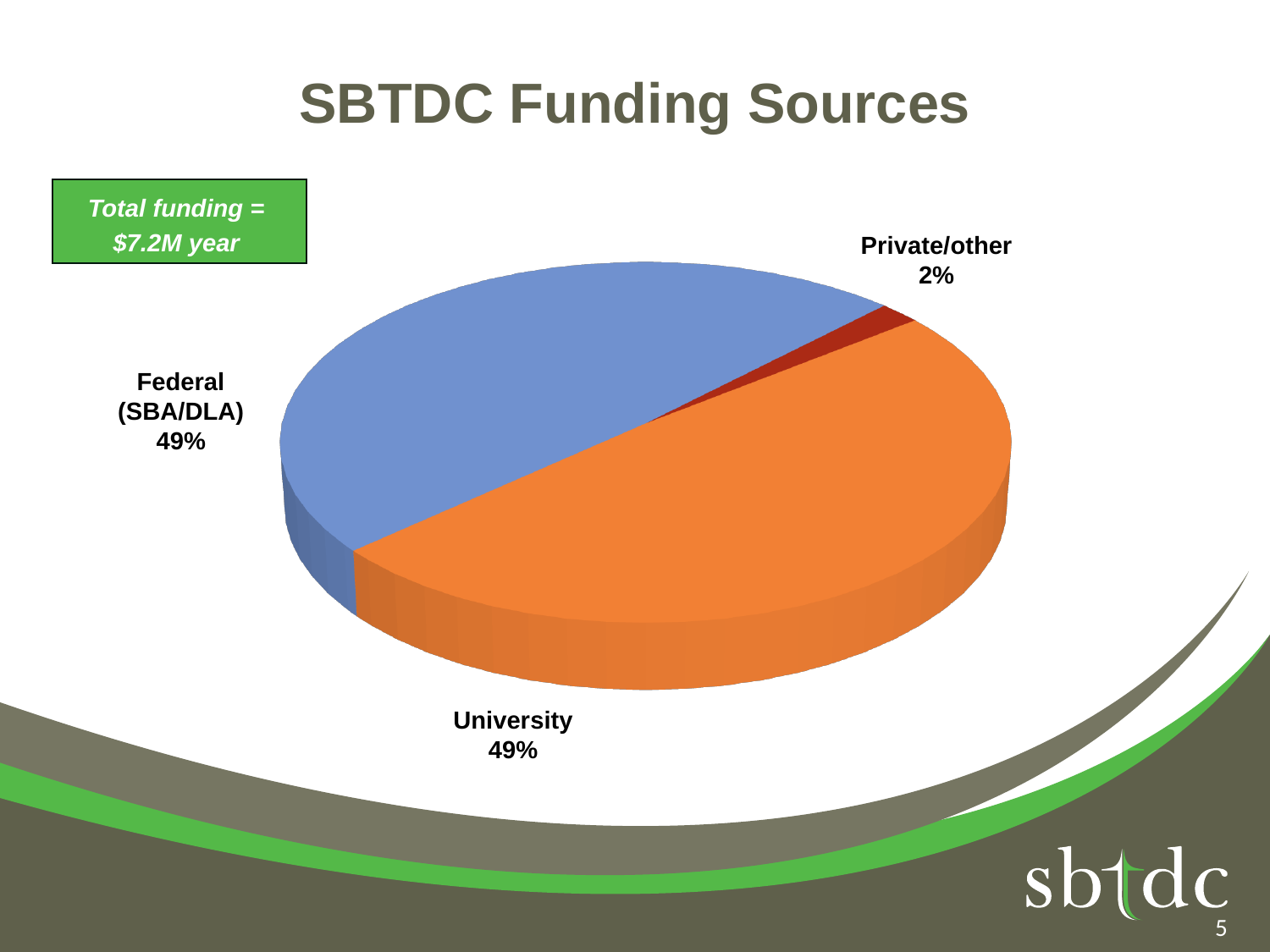
What share of SBTDC funding comes from Federal (SBA/DLA)? 49% What is the difference between the University share and the Private/other share? 47% How many slices does the pie chart have? 3 What is the title of the chart? SBTDC Funding Sources Which is larger, the Federal (SBA/DLA) share or the Private/other share? Federal (SBA/DLA) What share of SBTDC funding comes from Private/other? 2% What is the combined share of Federal (SBA/DLA) and University funding? 98% What total annual funding does the slide state? $7.2M year What share of SBTDC funding comes from University? 49% Which funding source has the smallest share of the pie? Private/other What kind of chart is shown on the slide? pie chart